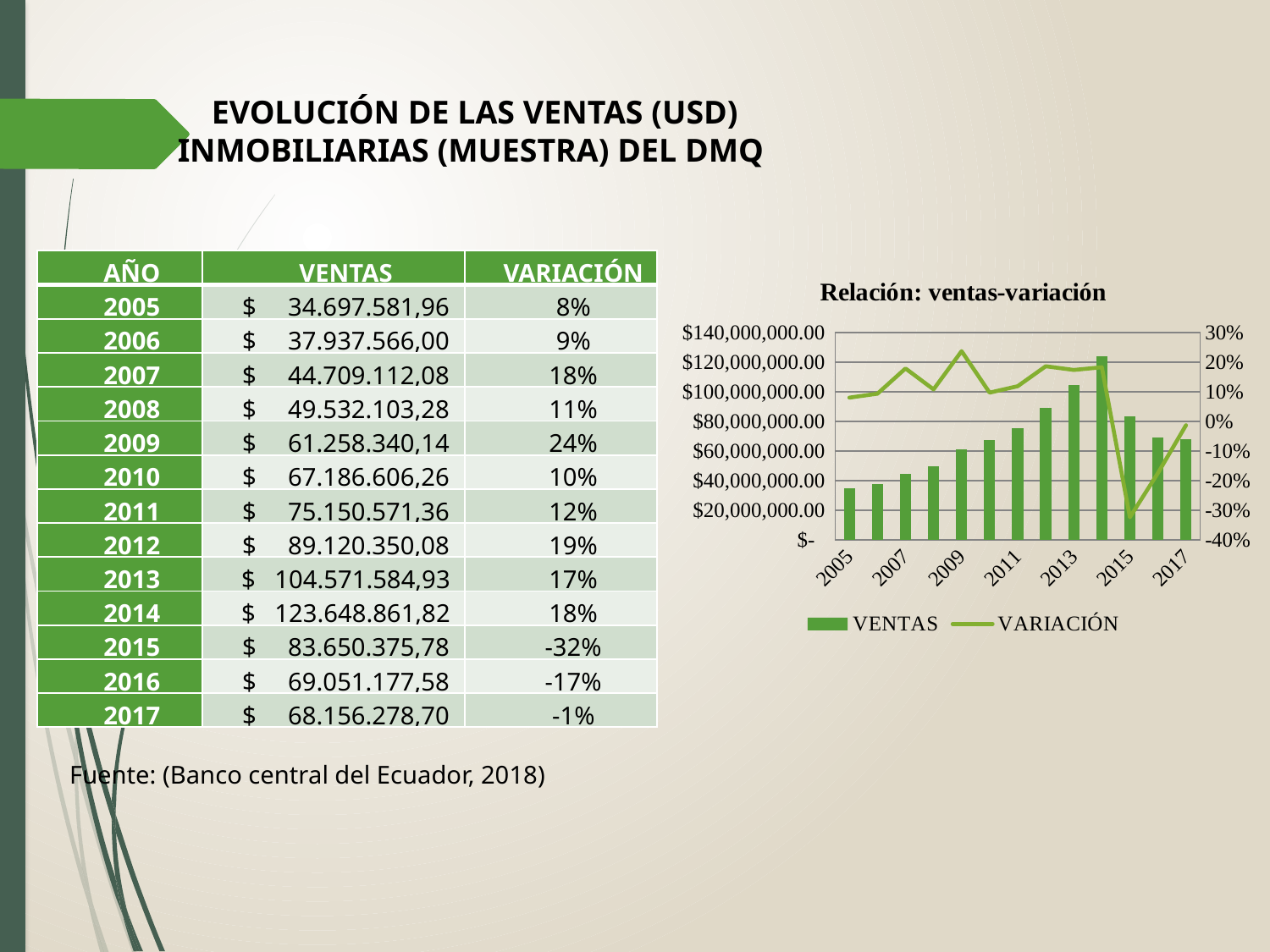
Which year has the larger VENTAS bar, 2010 or 2011? 2011 How many series does the chart legend list? 2 How many years are plotted along the x axis of the chart? 13 Which year has the lowest VENTAS bar in the chart? 2005 In which year does the VARIACIÓN line reach its lowest point? 2015 Do the VENTAS bars rise or fall from 2005 to 2014? rise What kind of chart is shown on the slide? A combined bar and line chart Is the VENTAS value for 2014 greater or less than $100,000,000.00? greater Is the VENTAS value for 2005 greater or less than $40,000,000.00? less Is the VARIACIÓN value for 2015 greater or less than -20%? less Which year has the highest VENTAS bar in the chart? 2014 What is the title of the chart on the slide? Relación: ventas-variación